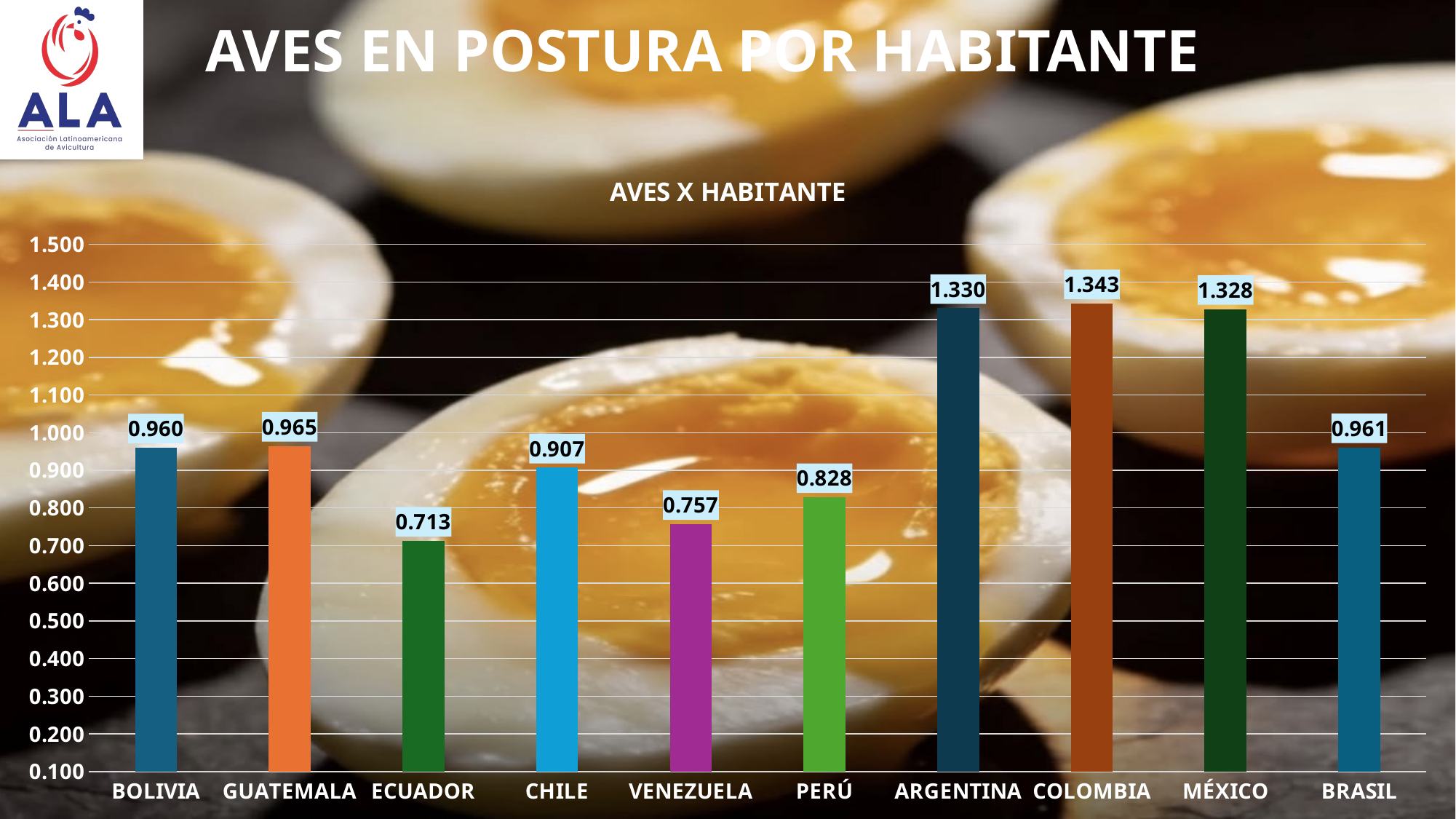
What is the difference between the values for Chile and Venezuela? 0.150 What is the value for Argentina in the chart? 1.330 What is the value for Ecuador in the chart? 0.713 Which has a larger value, Chile or Perú? Chile How many countries are shown in the chart? 10 What is the title of the chart? AVES X HABITANTE What is the difference between the values for Colombia and Ecuador? 0.630 Which country has the highest value in the chart? Colombia What kind of chart is shown on the slide? bar chart Which country has the lowest value in the chart? Ecuador What is the value for Perú in the chart? 0.828 Is the value for Venezuela greater or less than 0.800? less